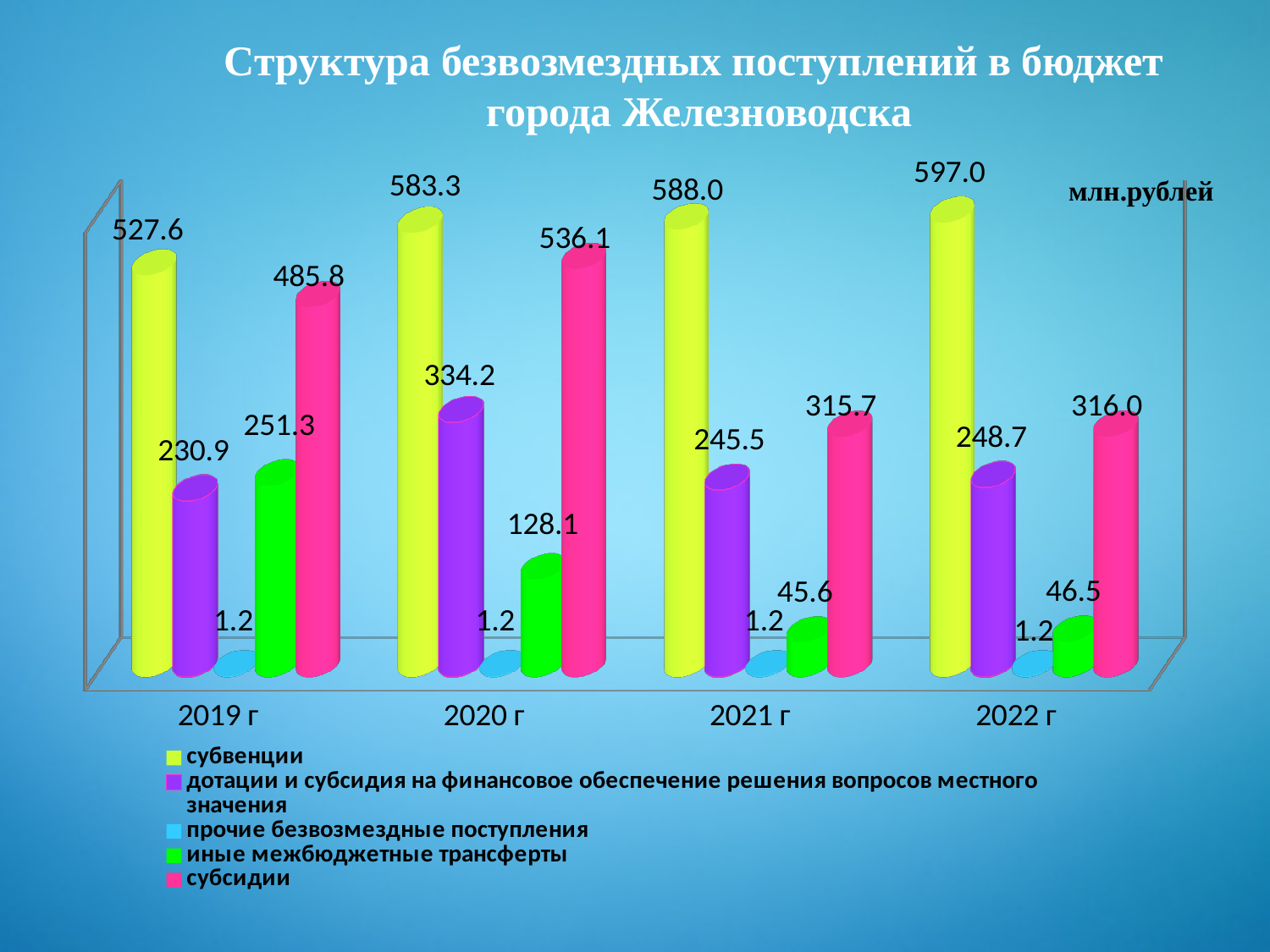
What is the value for дотации и субсидия на финансовое обеспечение решения вопросов местного значения in 2019 г? 230.9 How many years are shown on the x axis? 4 Which is larger in 2019 г: иные межбюджетные трансферты or дотации и субсидия на финансовое обеспечение решения вопросов местного значения? иные межбюджетные трансферты Do the values for субвенции rise or fall from 2019 г to 2022 г? rise How many series does the legend list? 5 What kind of chart is shown on the slide? bar chart What is the difference between субвенции and субсидии in 2021 г? 272.3 What is the value for иные межбюджетные трансферты in 2021 г? 45.6 What is the value for субвенции in 2022 г? 597.0 In which year is the value for иные межбюджетные трансферты the lowest? 2021 г What is the value for субсидии in 2020 г? 536.1 In which year is the value for субвенции the highest? 2022 г